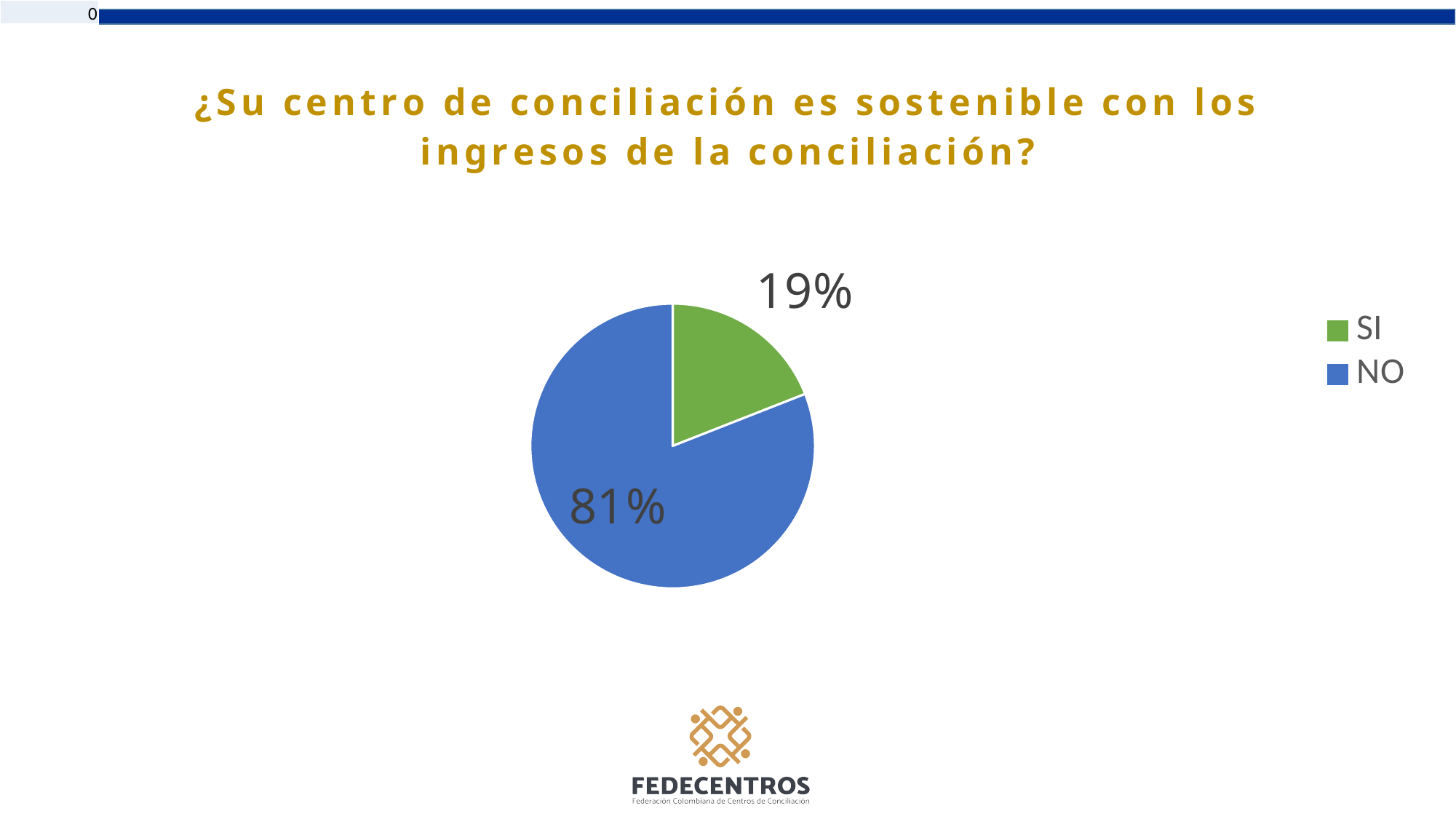
How many slices does the pie chart have? 2 What is the difference in percentage points between the NO and SI slices? 62 Which category has the largest share of the pie chart? NO How many entries does the legend list? 2 What percentage of the pie chart corresponds to NO? 81% Which category has the smallest share of the pie chart? SI What kind of chart is shown on the slide? Pie chart Which slice is larger, SI or NO? NO What share of the pie does the SI slice represent? 19% What is the title of the chart on the slide? ¿Su centro de conciliación es sostenible con los ingresos de la conciliación? What colour is the NO slice in the pie chart? Blue What percentage of the pie chart corresponds to SI? 19%